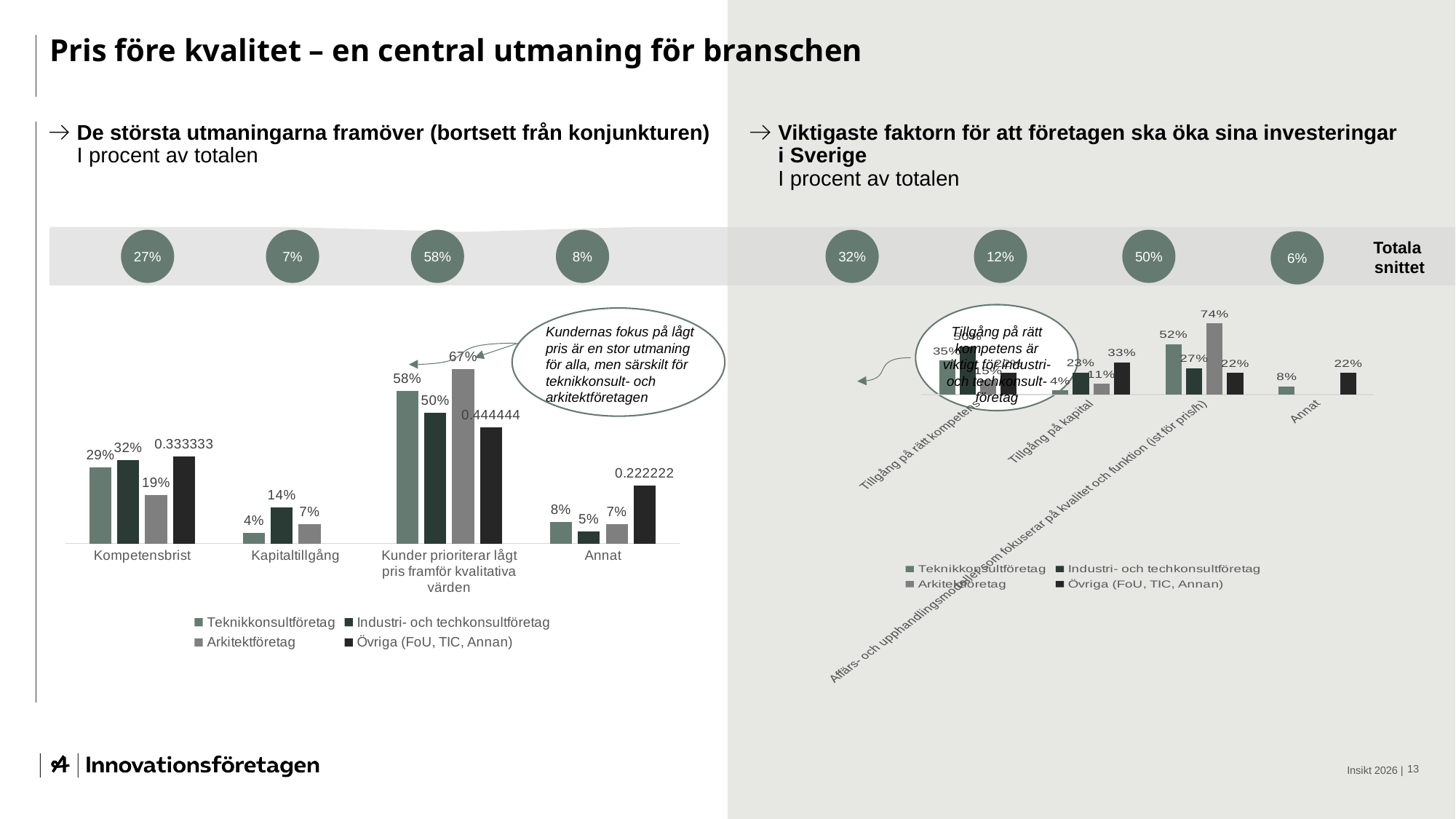
On the left chart (De största utmaningarna framöver), which is larger for Arkitektföretag: Kompetensbrist or Kapitaltillgång? Kompetensbrist How many categories are shown on the x axis of the left chart (De största utmaningarna framöver)? 4 What kind of chart is the right chart (Viktigaste faktorn för att företagen ska öka sina investeringar i Sverige)? Bar chart How many series does the legend of the left chart (De största utmaningarna framöver) list? 4 On the right chart (Viktigaste faktorn för att företagen ska öka sina investeringar i Sverige), what is the value for Arkitektföretag in the category Affärs- och upphandlingsmodeller som fokuserar på kvalitet och funktion (ist för pris/h)? 74% On the left chart (De största utmaningarna framöver), which series has the highest value in the category Kunder prioriterar lågt pris framför kvalitativa värden? Arkitektföretag On the right chart (Viktigaste faktorn för att företagen ska öka sina investeringar i Sverige), which series has the lowest value in the category Tillgång på kapital? Teknikkonsultföretag On the left chart (De största utmaningarna framöver), what is the value for Teknikkonsultföretag in the category Kompetensbrist? 29% On the right chart (Viktigaste faktorn för att företagen ska öka sina investeringar i Sverige), what is the value for Övriga (FoU, TIC, Annan) in the category Tillgång på kapital? 33% On the left chart (De största utmaningarna framöver), what is the value for Arkitektföretag in the category Kunder prioriterar lågt pris framför kvalitativa värden? 67% On the left chart (De största utmaningarna framöver), what is the difference between the Teknikkonsultföretag and Industri- och techkonsultföretag values in the category Kunder prioriterar lågt pris framför kvalitativa värden? 8% On the left chart (De största utmaningarna framöver), what is the value for Industri- och techkonsultföretag in the category Kapitaltillgång? 14%